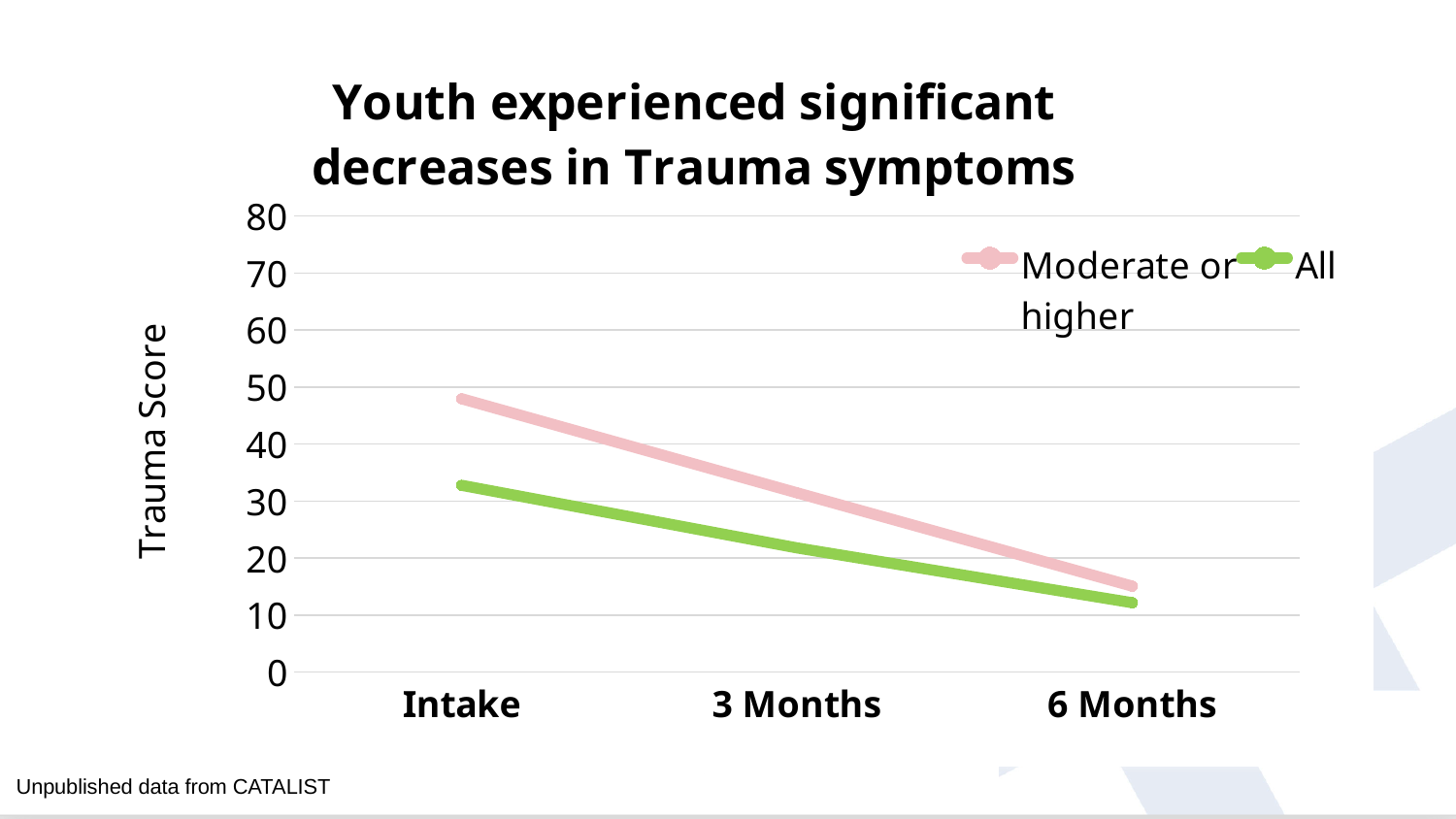
How many time points are shown on the x axis? 3 Which colour represents the All series? green What kind of chart is shown on the slide? line chart At which time point is the All series lowest? 6 Months Is the Intake value for All greater or less than 40? less At which time point is the Moderate or higher series highest? Intake How many series does the legend list? 2 What is the label on the vertical axis? Trauma Score At Intake, which series has the higher trauma score, Moderate or higher or All? Moderate or higher Is the Intake value for Moderate or higher greater or less than 40? greater Is the 6 Months value for All greater or less than 20? less Do the trauma scores rise or fall from Intake to 6 Months? fall